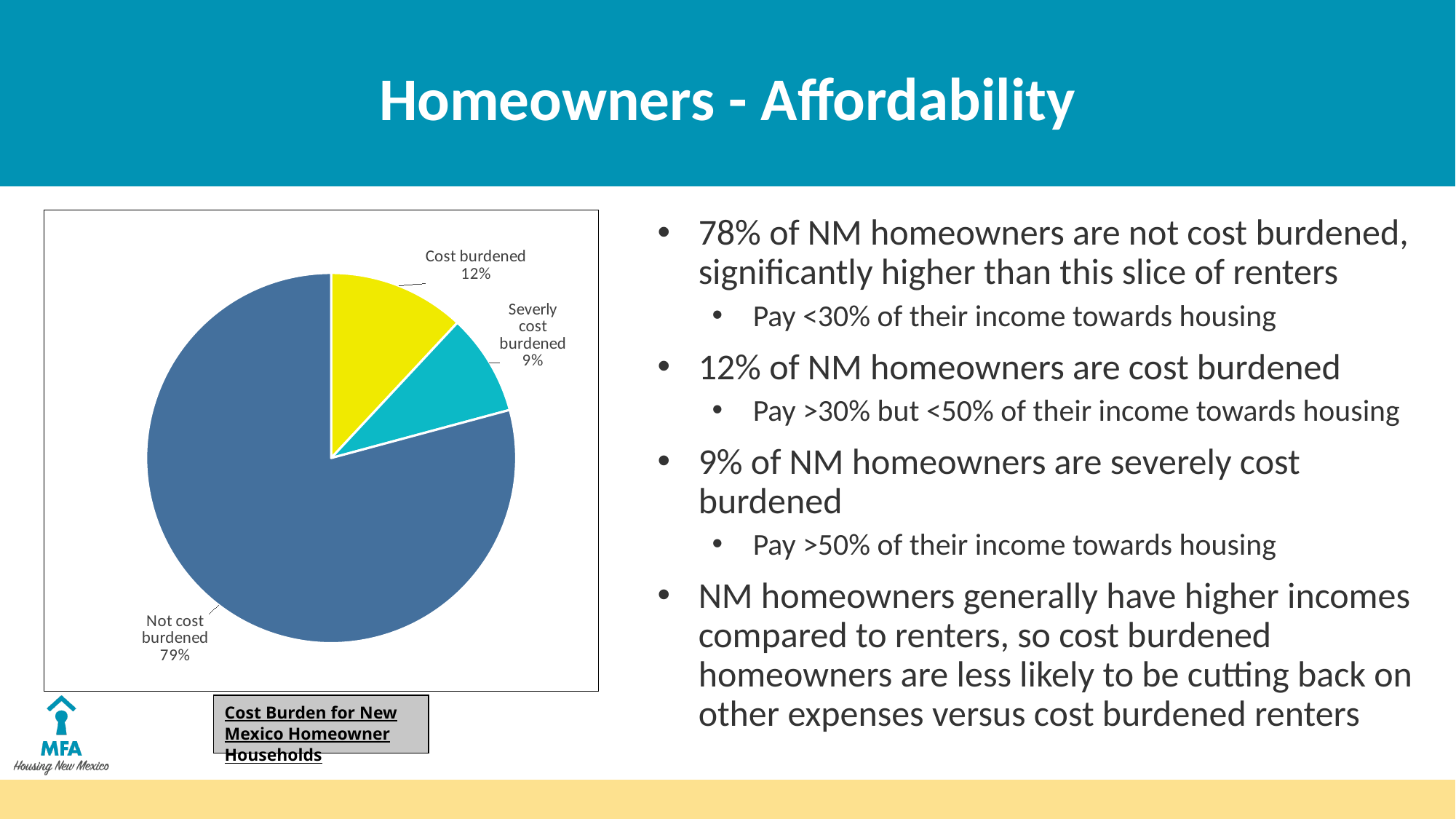
What is the difference in percentage points between the "Cost burdened" slice and the "Severly cost burdened" slice? 3 Which is larger, the "Cost burdened" slice or the "Severly cost burdened" slice? Cost burdened Which slice of the pie chart is the smallest? Severly cost burdened What share of the pie is labelled "Cost burdened"? 12% Which slice of the pie chart is the largest? Not cost burdened What share of the pie is labelled "Not cost burdened"? 79% What share of the pie is labelled "Severly cost burdened"? 9% What kind of chart is shown on the slide? Pie chart How many slices does the pie chart have? 3 What colour is the "Cost burdened" slice of the pie chart? Yellow What is the difference in percentage points between the "Not cost burdened" slice and the "Cost burdened" slice? 67 What is the title of the pie chart given in the caption box below it? Cost Burden for New Mexico Homeowner Households